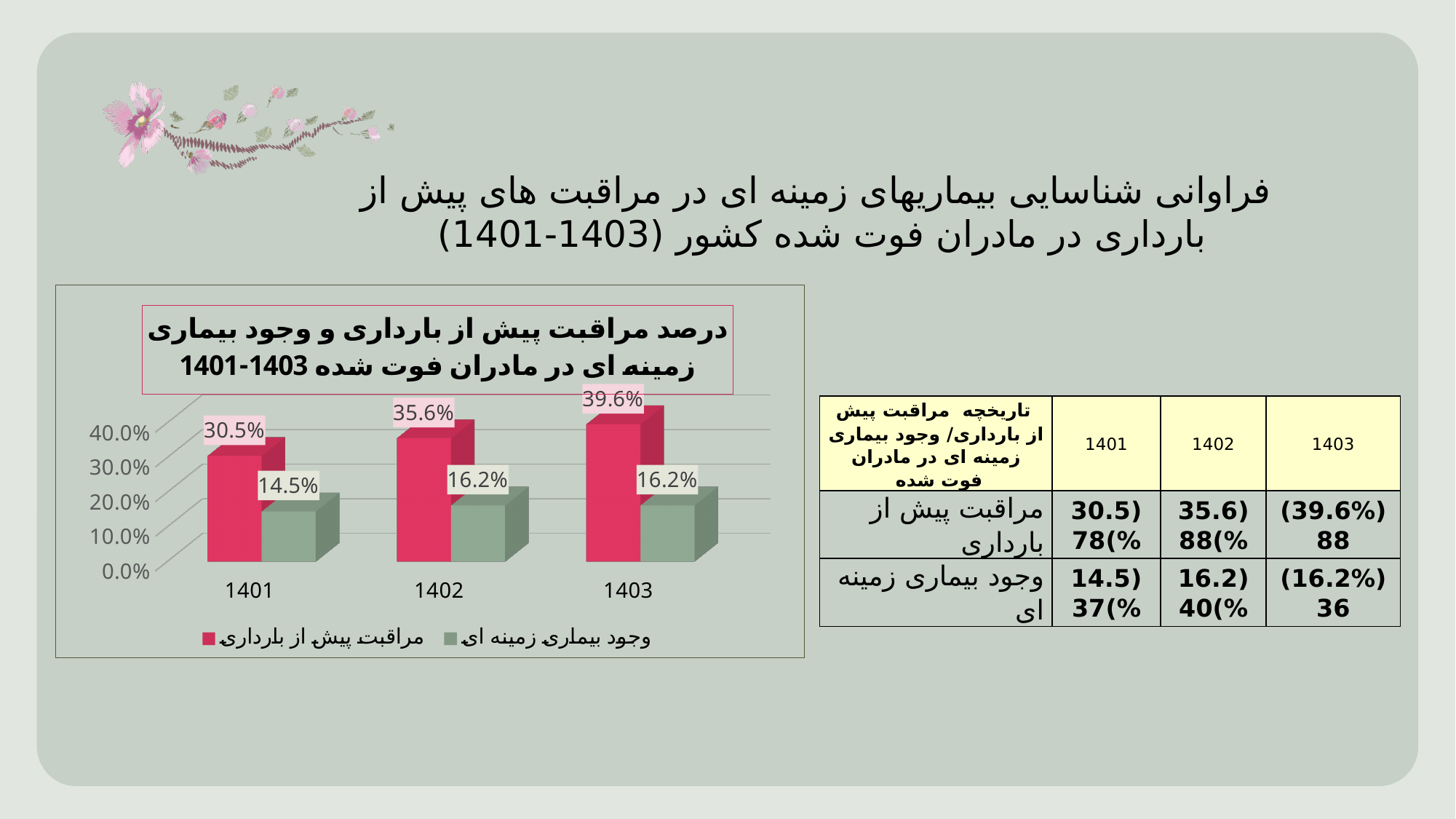
How many series does the chart legend list? 2 What type of chart is shown on the slide? bar chart How many years are shown on the x axis of the chart? 3 In which year is the value for وجود بیماری زمینه ای lowest? 1401 What is the difference between the مراقبت پیش از بارداری values for 1403 and 1401? 9.1% What is the value for مراقبت پیش از بارداری in 1401? 30.5% What is the value for وجود بیماری زمینه ای in 1401? 14.5% Which is larger in 1402: مراقبت پیش از بارداری or وجود بیماری زمینه ای? مراقبت پیش از بارداری Does the value for مراقبت پیش از بارداری rise or fall from 1401 to 1403? rise What is the value for مراقبت پیش از بارداری in 1403? 39.6% In which year is the value for مراقبت پیش از بارداری highest? 1403 What is the value for وجود بیماری زمینه ای in 1402? 16.2%